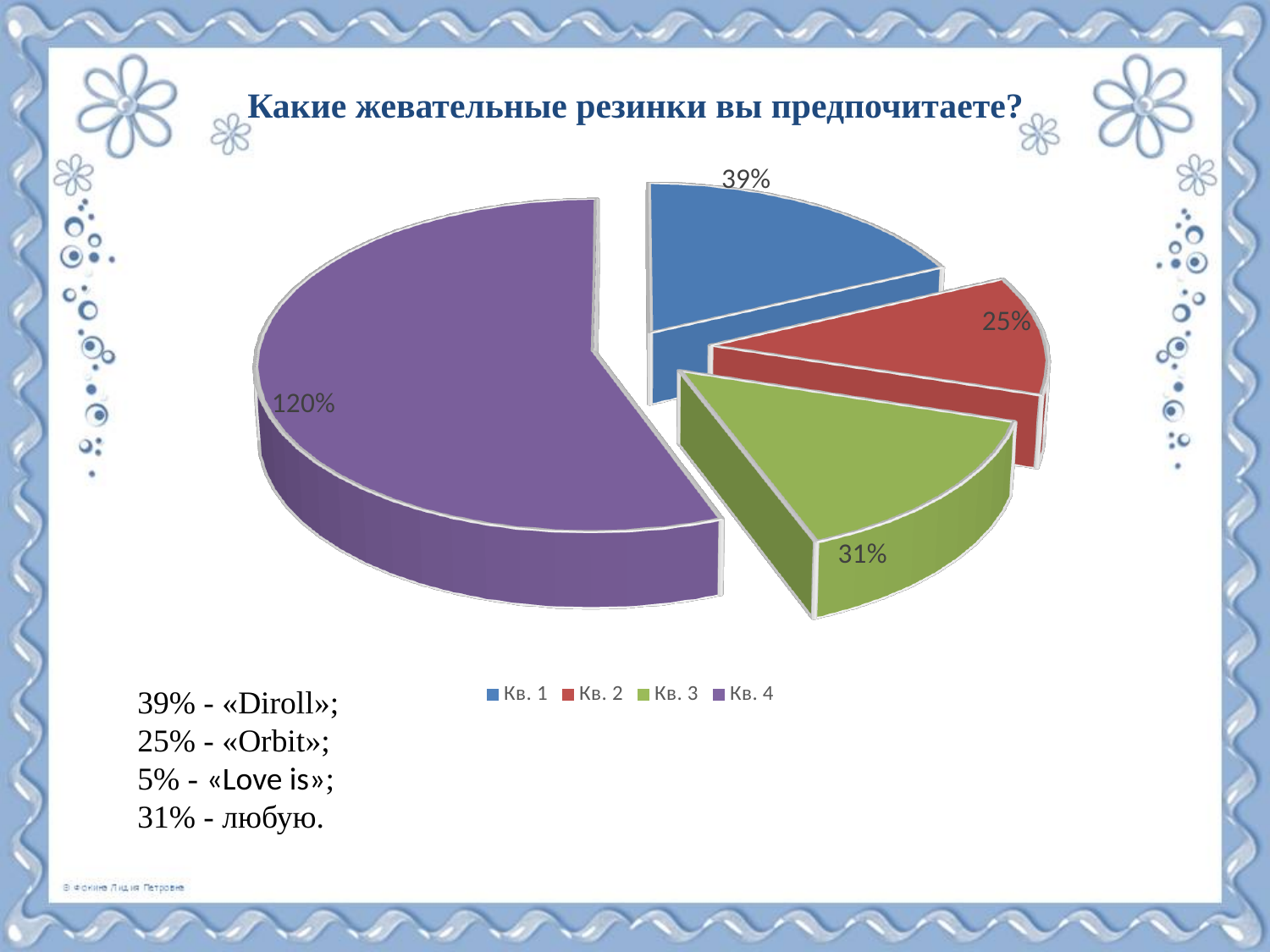
What type of chart is shown on the slide? Pie chart Which slice has the larger labelled value, Кв. 1 or Кв. 3? Кв. 1 What colour is the Кв. 4 slice in the pie chart? Purple How many entries does the chart legend list? 4 What is the data label shown on the Кв. 3 slice of the pie chart? 31% What is the data label shown on the Кв. 2 slice of the pie chart? 25% By how many percentage points does the Кв. 1 label exceed the Кв. 2 label? 14 percentage points Which slice of the pie chart has the largest labelled value? Кв. 4 Which slice of the pie chart has the smallest labelled value? Кв. 2 What is the data label shown on the Кв. 4 slice of the pie chart? 120% What is the data label shown on the Кв. 1 slice of the pie chart? 39% How many slices does the pie chart have? 4